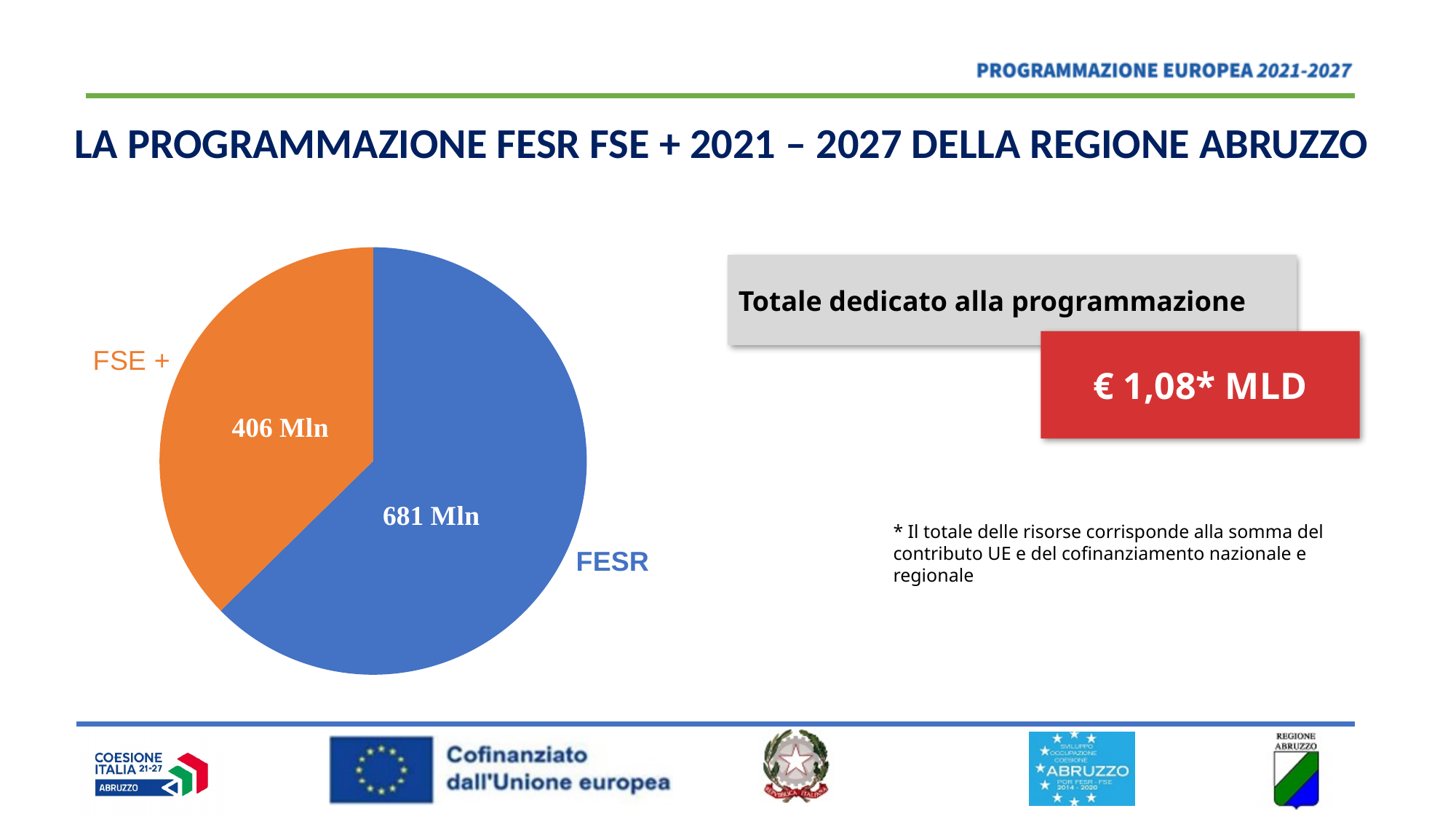
Which slice of the pie chart is the largest? FESR What is the value shown for FSE + in the pie chart? 406 Mln Which slice of the pie chart is the smallest? FSE + Which is larger in the pie chart, FESR or FSE +? FESR What kind of chart is shown on the slide? pie chart What is the sum of the two slice values in the pie chart? 1087 Mln What is the value shown for FESR in the pie chart? 681 Mln What share of the pie does the FESR slice represent, to one decimal place? 62.6% What is the difference between the FESR value and the FSE + value in the pie chart? 275 Mln What colour is the FSE + slice in the pie chart? orange What total amount is shown in the red box next to the pie chart? € 1,08* MLD How many slices does the pie chart have? 2